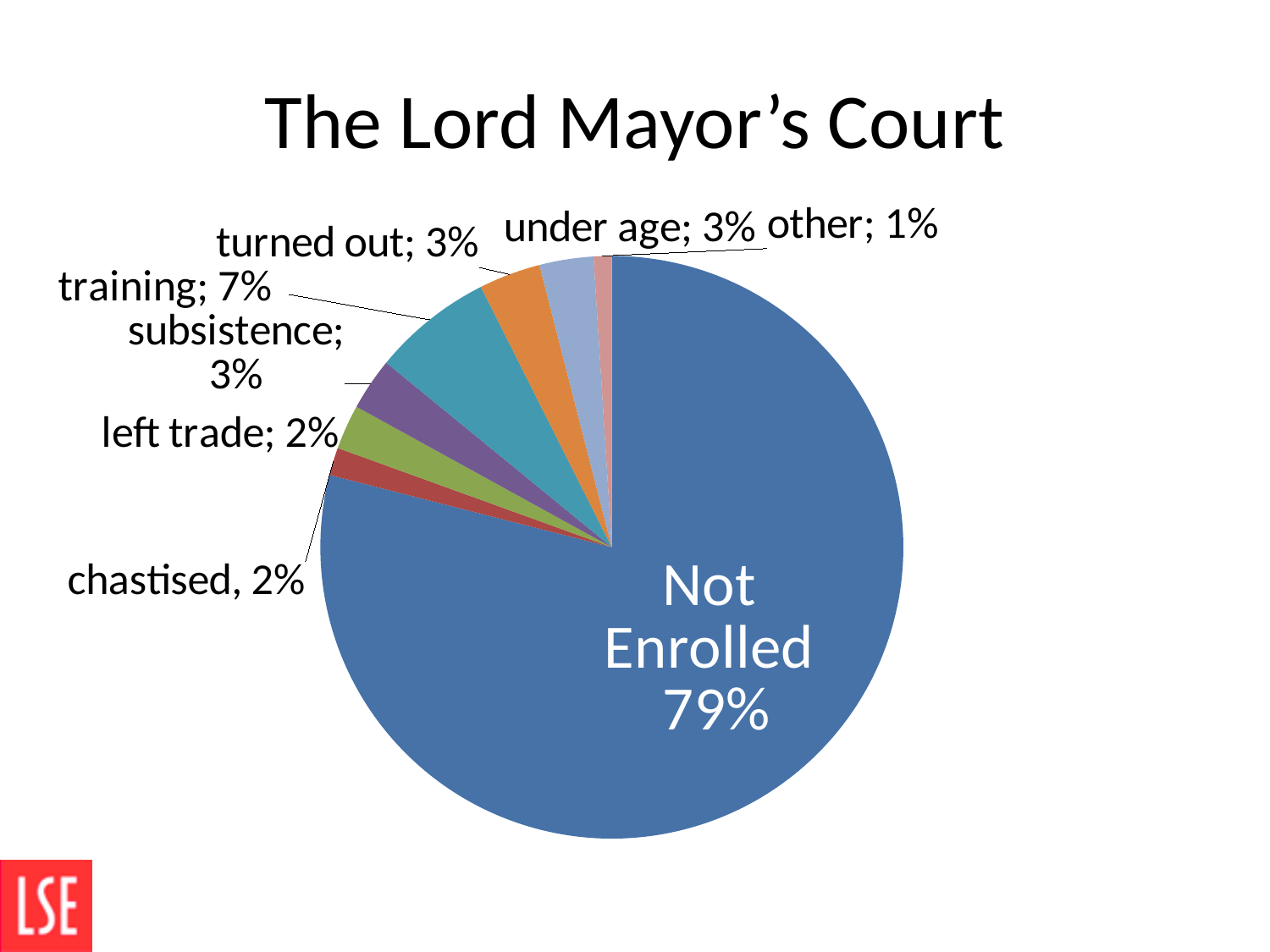
What percentage is shown for other? 1% Which is larger, the share for training or the share for under age? training Which slice of the pie is the largest? Not Enrolled What percentage is shown for turned out? 3% What percentage is shown for chastised? 2% Which slice of the pie is the smallest? other How many slices does the pie chart have? 8 What is the difference in percentage points between Not Enrolled and training? 72 What is the title of the chart? The Lord Mayor's Court What kind of chart is shown on the slide? pie chart What share of the pie is labelled Not Enrolled? 79% What percentage is shown for training? 7%